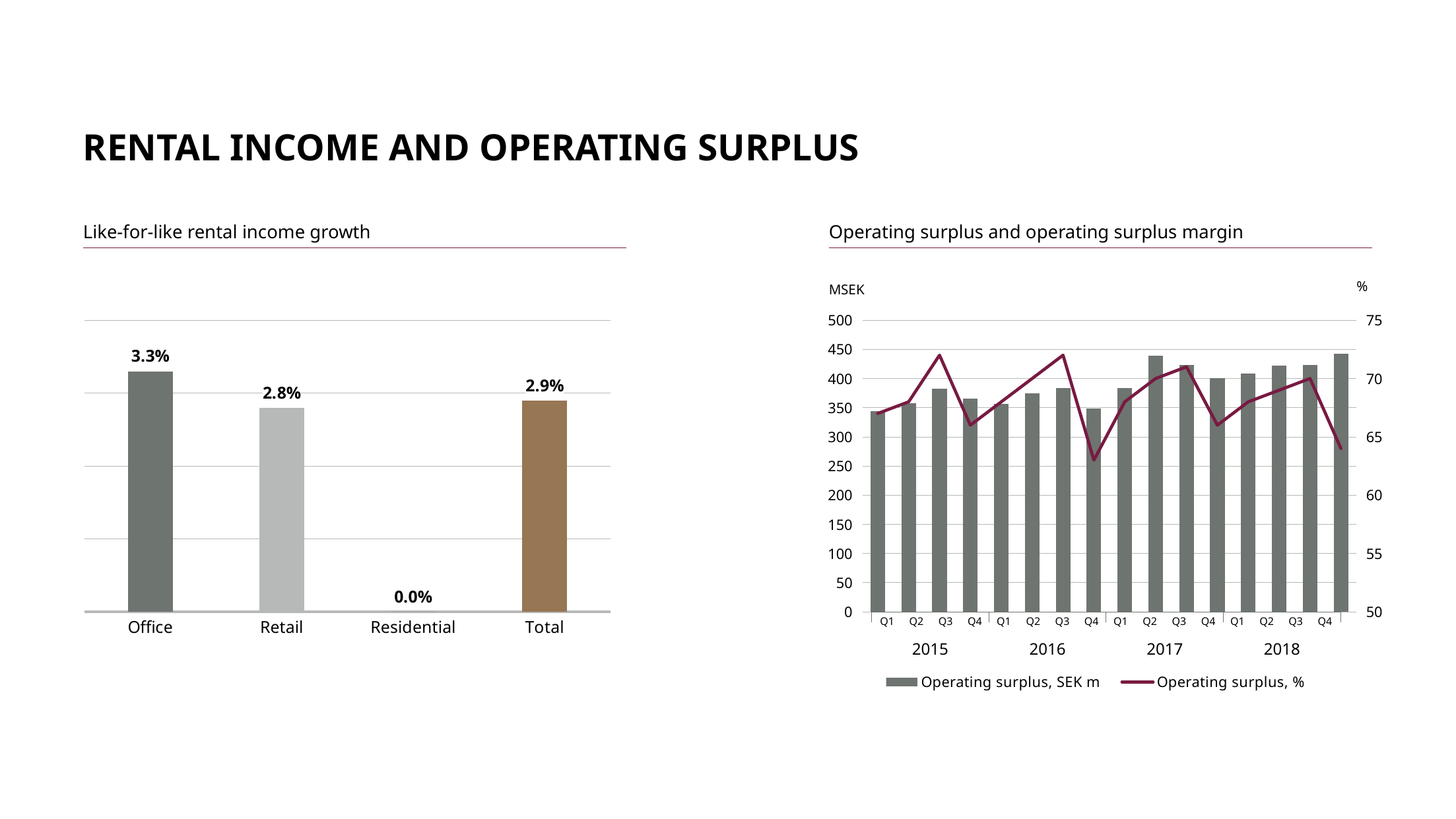
How many series does the legend of the 'Operating surplus and operating surplus margin' chart list? 2 In the 'Like-for-like rental income growth' chart, which category has the lowest value? Residential In the 'Operating surplus and operating surplus margin' chart, is the operating surplus in SEK m for Q4 2018 greater or less than 400? greater What kind of chart is the 'Like-for-like rental income growth' chart? Bar chart In the 'Like-for-like rental income growth' chart, which is larger, the value for Total or the value for Retail? Total In the 'Like-for-like rental income growth' chart, what is the value for Retail? 2.8% In the 'Like-for-like rental income growth' chart, which category has the highest value? Office In the 'Like-for-like rental income growth' chart, what is the value for Office? 3.3% In the 'Operating surplus and operating surplus margin' chart, is the operating surplus in SEK m for Q4 2016 greater or less than 400? less In the 'Like-for-like rental income growth' chart, what is the value for Residential? 0.0% In the 'Like-for-like rental income growth' chart, what is the difference between the Office and Retail values? 0.5% How many categories are shown in the 'Like-for-like rental income growth' chart? 4